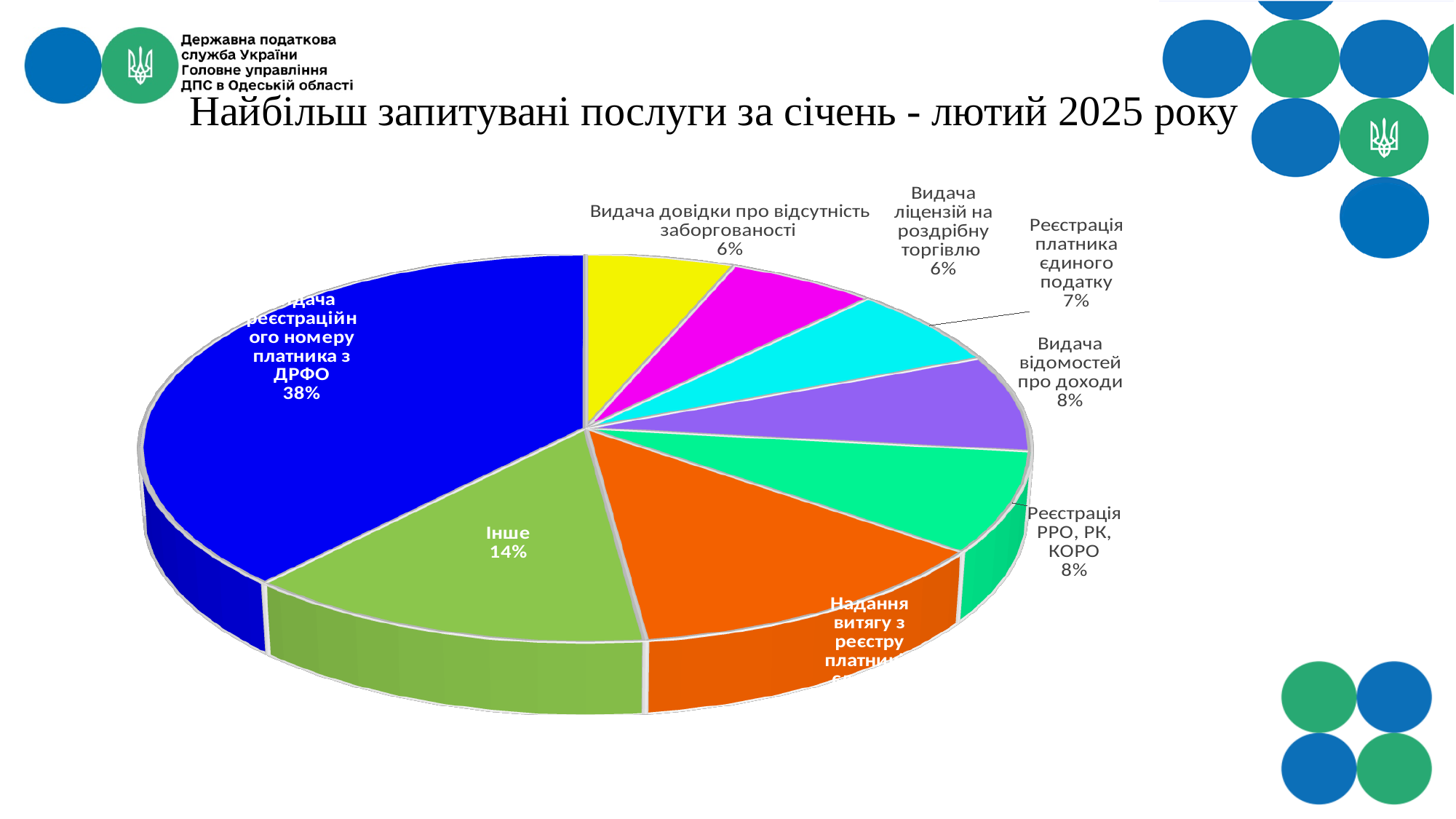
How many slices does the pie chart have? 8 What is the value shown for "Видача довідки про відсутність заборгованості"? 6% What share of the pie does "Інше" have? 14% What is the value shown for "Реєстрація платника єдиного податку"? 7% What is the difference in percentage points between "Видача реєстраційного номеру платника з ДРФО" and "Інше"? 24 Which service has the largest share of the pie? Видача реєстраційного номеру платника з ДРФО What is the title of the chart? Найбільш запитувані послуги за січень - лютий 2025 року Which is larger: the share for "Інше" or the share for "Реєстрація РРО, РК, КОРО"? Інше What is the value shown for "Видача ліцензій на роздрібну торгівлю"? 6% What share of the pie does "Видача реєстраційного номеру платника з ДРФО" have? 38% What is the value shown for "Видача відомостей про доходи"? 8% What kind of chart is shown on the slide? pie chart